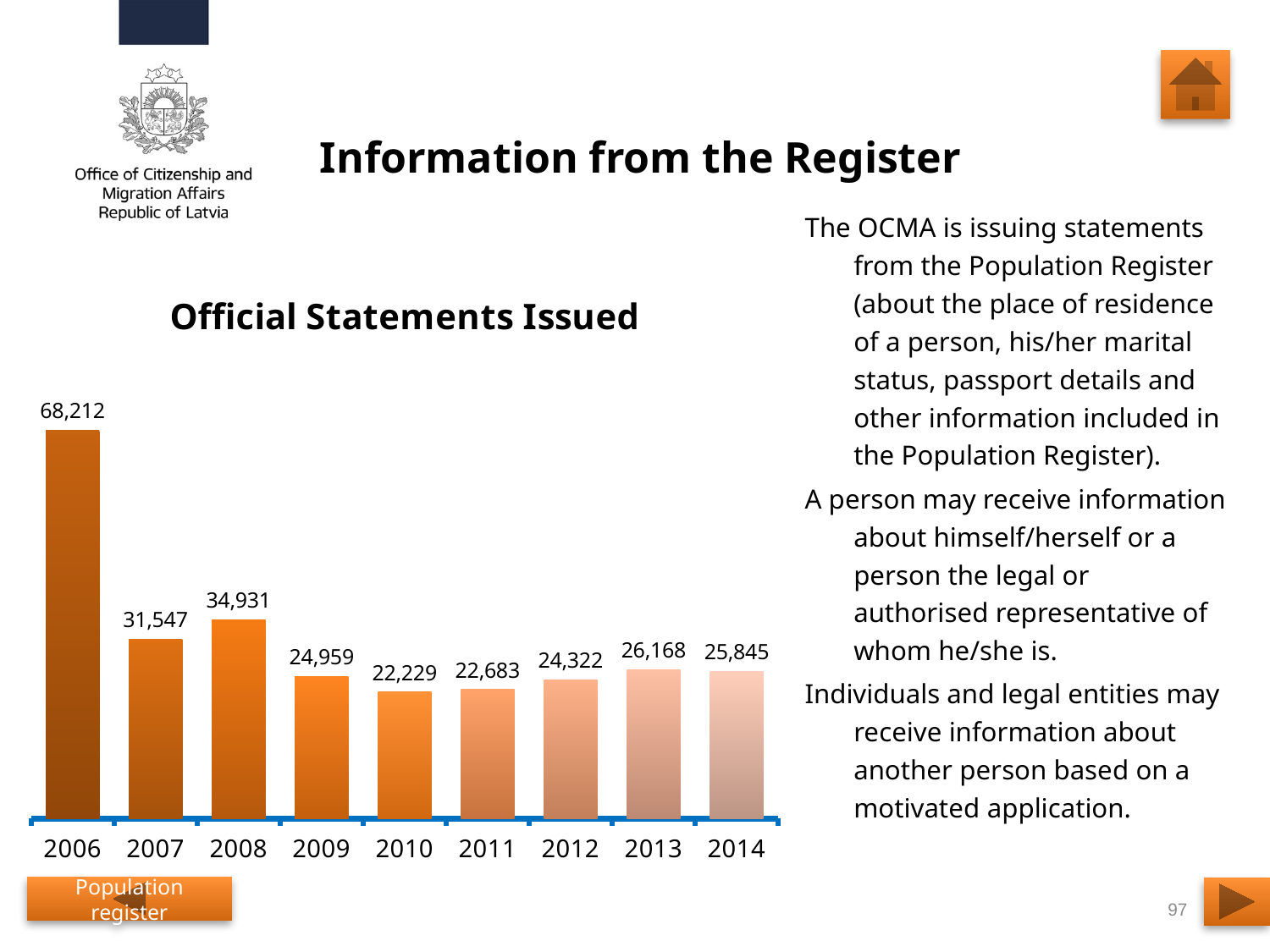
What is the value for 2006 in the Official Statements Issued chart? 68,212 How many official statements were issued in 2010? 22,229 Which year has the highest number of official statements issued? 2006 What is the difference between the values for 2013 and 2014? 323 Which year has the lowest number of official statements issued? 2010 What is the title of the chart on the slide? Official Statements Issued What is the value shown for 2014? 25,845 Do the values generally rise or fall from 2006 to 2010? fall How many years are shown on the x axis of the chart? 9 What kind of chart is used to show the official statements issued? bar chart Which year has a larger value, 2008 or 2009? 2008 What is the difference between the values for 2006 and 2007? 36,665